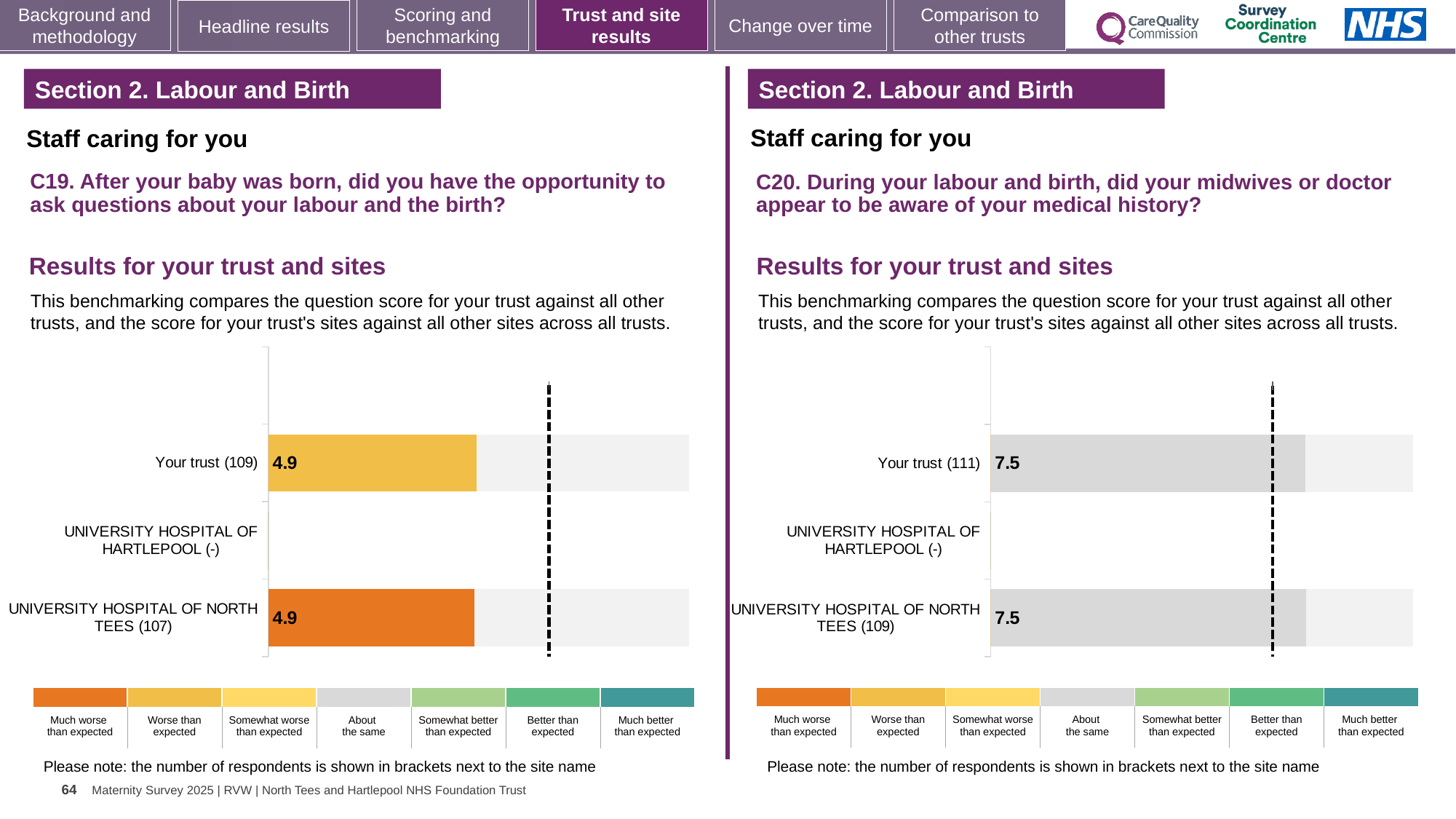
In the right chart (C20), how many respondents are shown in brackets for University Hospital of North Tees? 109 What kind of chart is used for the C19 results on the left? Bar chart How many categories are listed on the y axis of the left chart (C19)? 3 How many categories are listed on the y axis of the right chart (C20)? 3 In the left chart (C19), how many respondents are shown in brackets for Your trust? 109 How many rating bands does the colour key below the left chart (C19) show? 7 In the right chart (C20), what is the score for Your trust? 7.5 Which category in the left chart (C19) has no bar plotted? University Hospital of Hartlepool (-) In the left chart (C19), what is the score for University Hospital of North Tees? 4.9 In the right chart (C20), what is the score for University Hospital of North Tees? 7.5 In the right chart (C20), what is the difference between the score for Your trust and the score for University Hospital of North Tees? 0 In the left chart (C19), what is the score for Your trust? 4.9